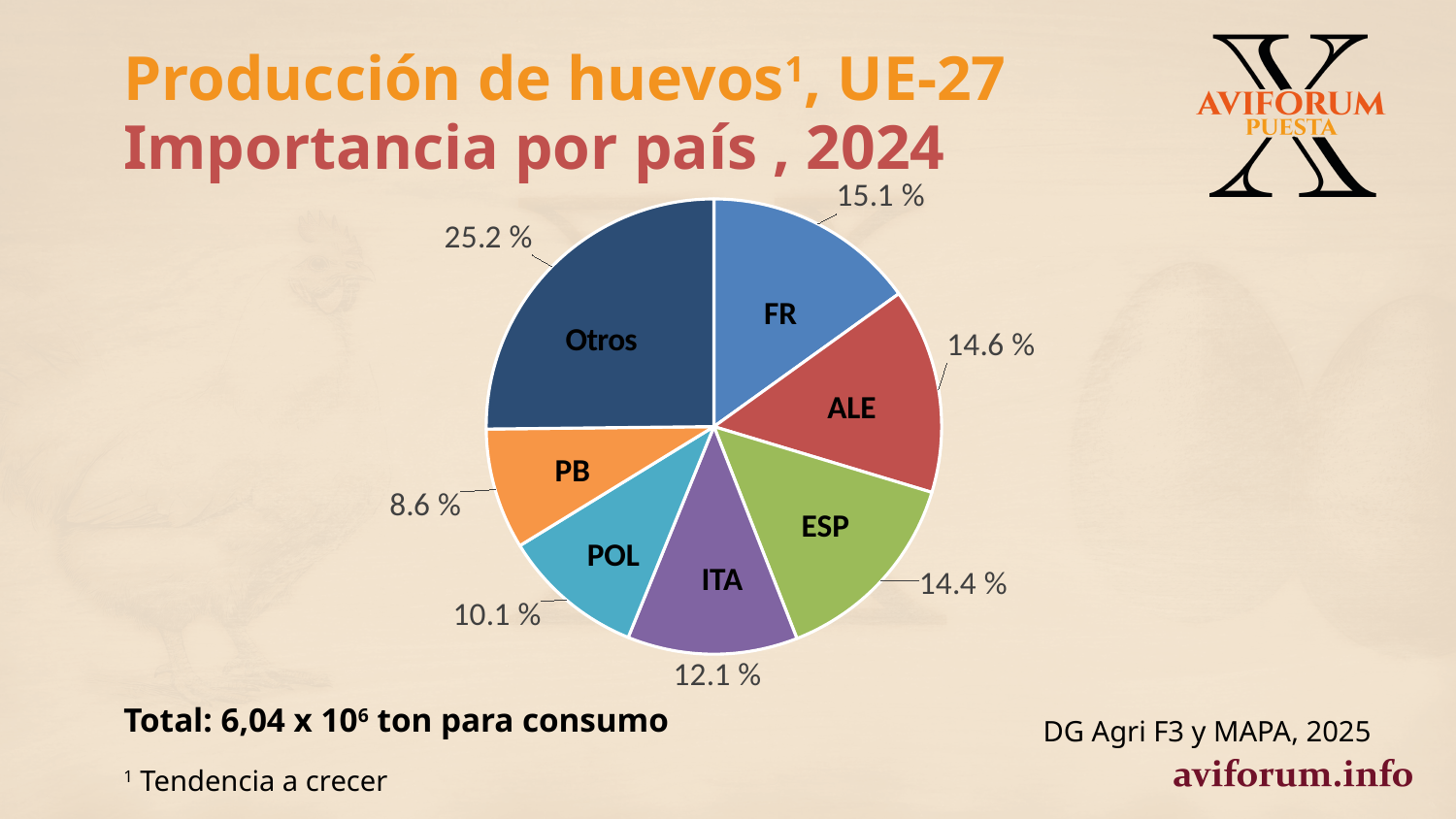
Which slice of the pie chart is the largest? Otros What share does ITA have in the pie chart? 12.1 % What share of egg production does FR have in the pie chart? 15.1 % What is the title of the slide containing the pie chart? Producción de huevos, UE-27 Importancia por país, 2024 What is the difference between the shares of FR and ALE? 0.5 % What is the difference between the shares of POL and PB? 1.5 % Which has a larger share, ITA or POL? ITA What type of chart is shown on the slide? Pie chart What share does PB have in the pie chart? 8.6 % Which slice of the pie chart is the smallest? PB What share does ESP have in the pie chart? 14.4 % How many slices does the pie chart have? 7